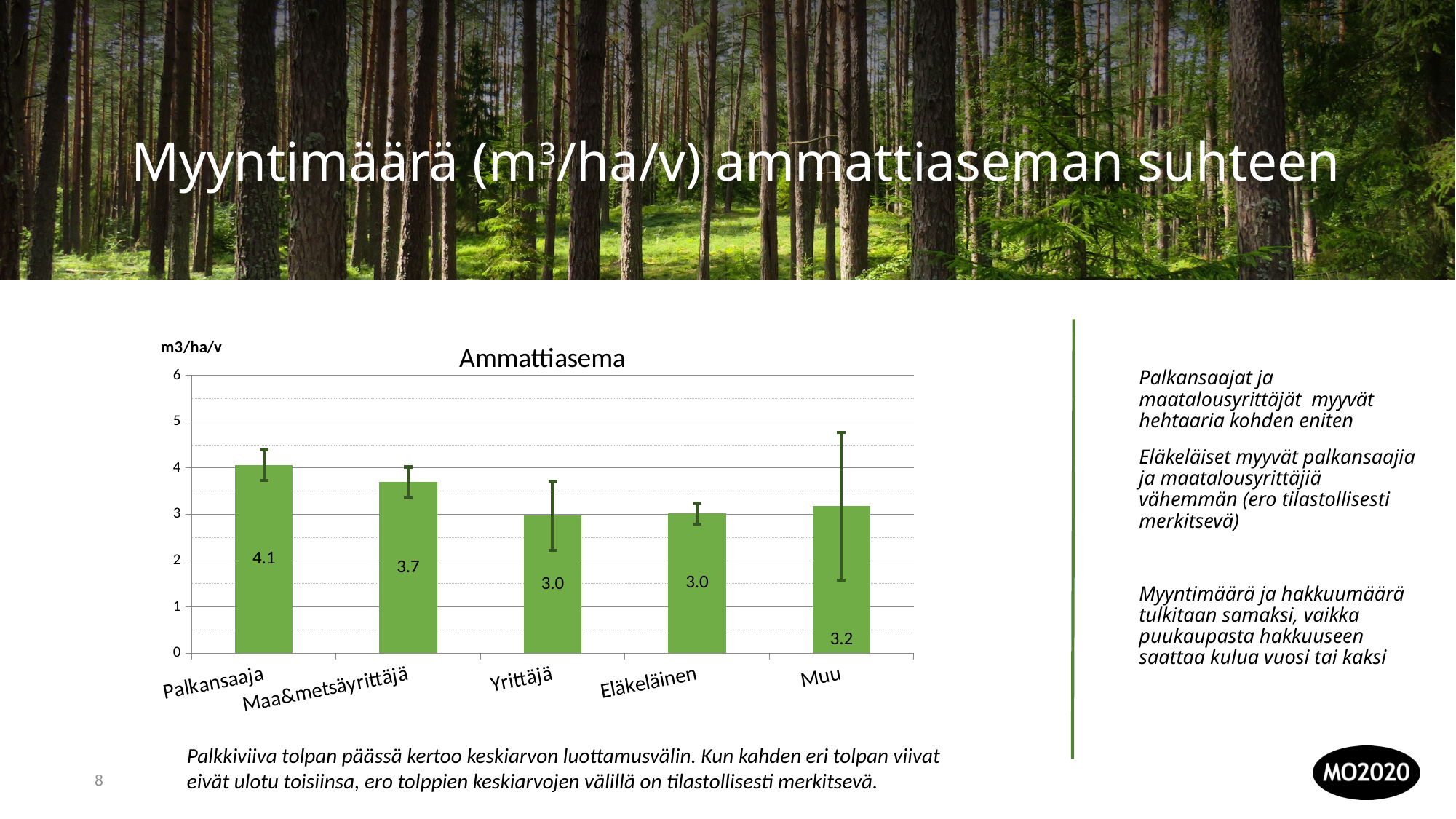
What kind of chart is shown on the slide? bar chart What is the difference between the values for Palkansaaja and Maa&metsäyrittäjä? 0.4 Which is larger, the value for Muu or the value for Maa&metsäyrittäjä? Maa&metsäyrittäjä Which category has the highest value? Palkansaaja What is the value for Eläkeläinen? 3.0 What is the value for Muu? 3.2 What is the value for Maa&metsäyrittäjä? 3.7 What is the title of the chart? Ammattiasema What is the difference between the values for Palkansaaja and Yrittäjä? 1.1 What is the value for Palkansaaja? 4.1 Is the value for Muu greater or less than 3? greater How many categories are shown on the x axis? 5